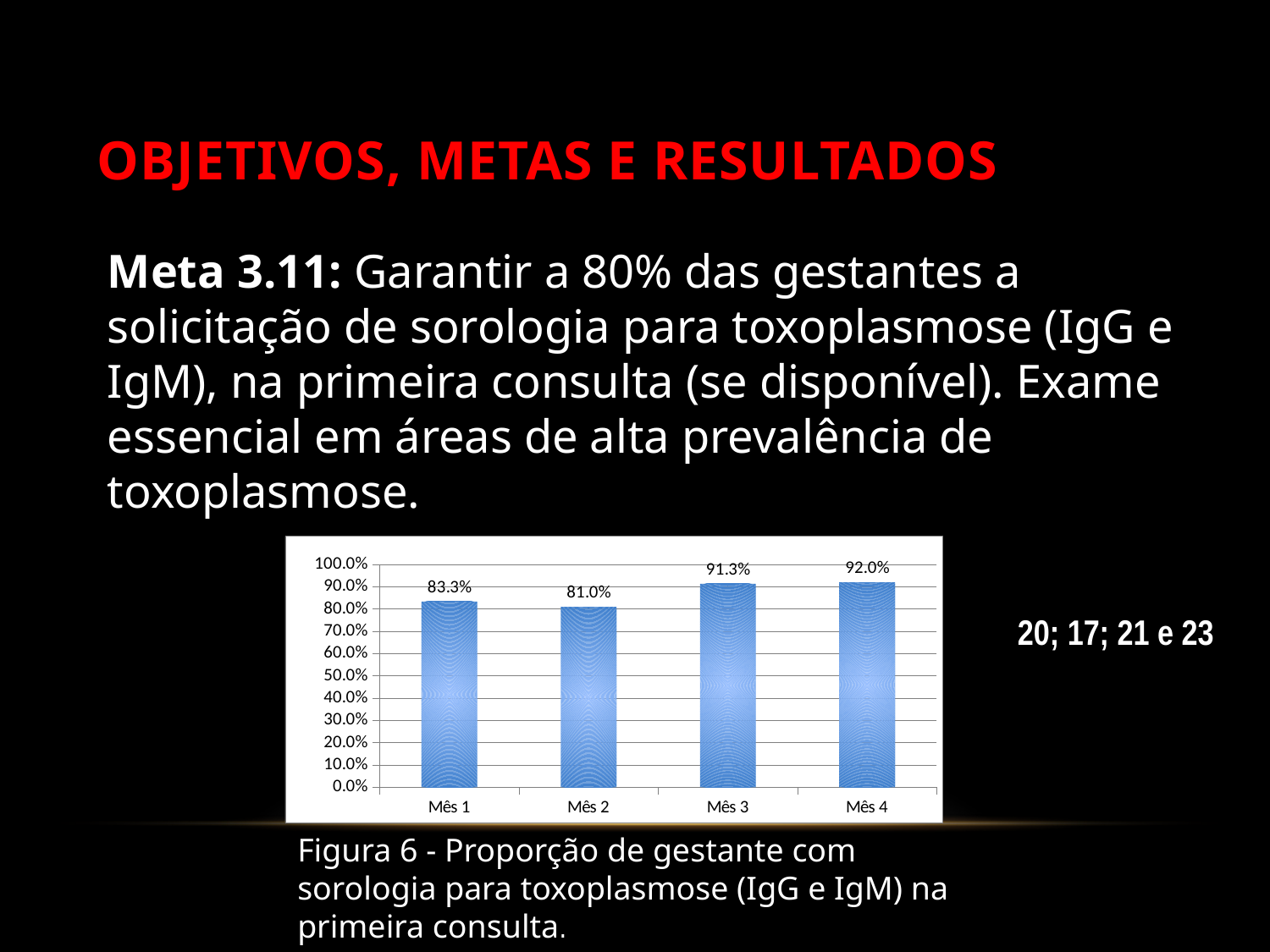
What is the difference between the values for Mês 3 and Mês 2? 10.3% Which is larger, the value for Mês 1 or the value for Mês 2? Mês 1 What is the value for Mês 3? 91.3% What kind of chart is shown on the slide? bar chart What is the figure caption below the chart? Figura 6 - Proporção de gestante com sorologia para toxoplasmose (IgG e IgM) na primeira consulta. Is the value for Mês 3 greater or less than 90.0%? greater What is the value for Mês 4? 92.0% How many months are shown on the x axis? 4 What is the value for Mês 1? 83.3% What is the value for Mês 2? 81.0% Which month has the highest value? Mês 4 Which month has the lowest value? Mês 2